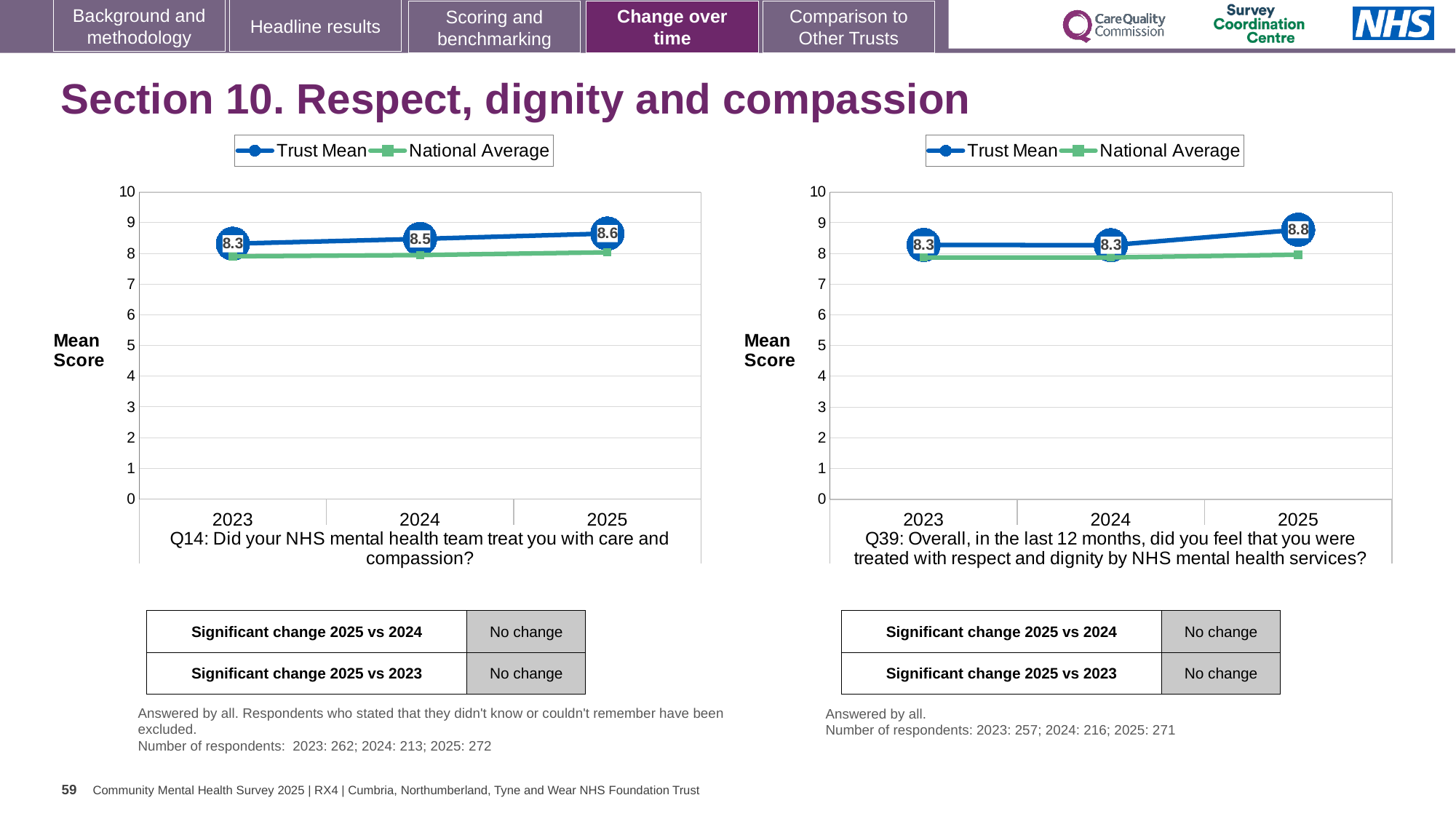
What type of chart is used for Q39 on the right? line chart In the right chart (Q39), is the National Average for 2025 greater or less than 9? less In the right chart (Q39), what is the Trust Mean for 2024? 8.3 In the left chart (Q14), which is higher in 2025, the Trust Mean or the National Average? Trust Mean In the right chart (Q39), which year has the highest Trust Mean? 2025 In the right chart (Q39), what is the difference between the Trust Mean in 2025 and in 2024? 0.5 In the left chart (Q14), by how much did the Trust Mean change from 2023 to 2025? 0.3 In the left chart (Q14), what is the Trust Mean for 2025? 8.6 How many series does the legend of the left chart (Q14) list? 2 In the right chart (Q39), what is the Trust Mean for 2025? 8.8 In the left chart (Q14), does the Trust Mean rise or fall from 2023 to 2025? rise In the left chart (Q14), what is the Trust Mean for 2023? 8.3